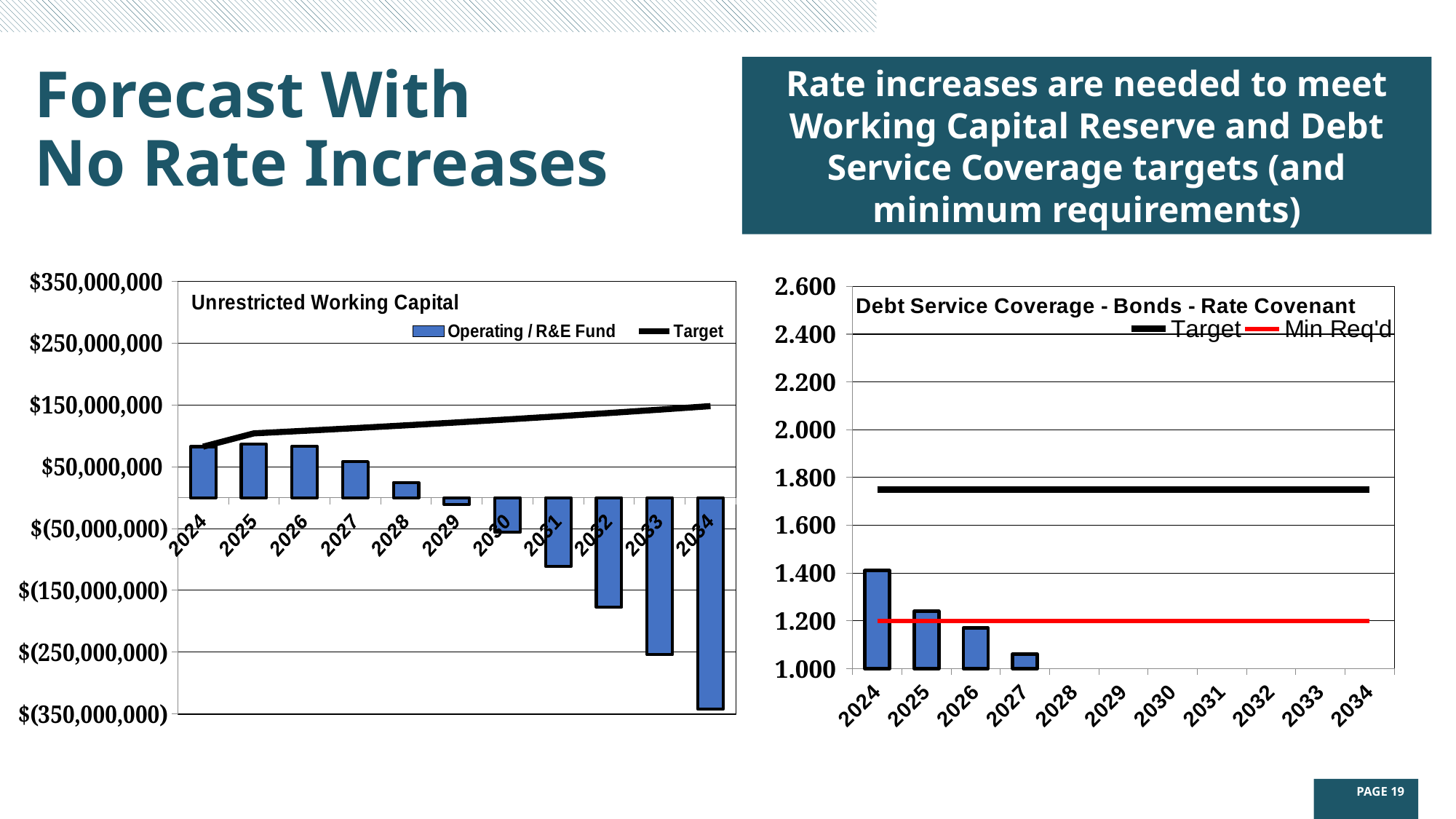
In the Unrestricted Working Capital chart, is the Operating / R&E Fund value for 2024 greater or less than $50,000,000? greater What kind of chart is the Unrestricted Working Capital chart on the left? combination bar and line chart In the Unrestricted Working Capital chart, is the Operating / R&E Fund value for 2034 greater or less than $(250,000,000)? less How many years are shown on the x axis of the Unrestricted Working Capital chart? 11 In the Debt Service Coverage - Bonds - Rate Covenant chart, which year has the highest bar? 2024 In the Unrestricted Working Capital chart, do the Operating / R&E Fund values generally rise or fall from 2024 to 2034? fall Which two line series does the legend of the Debt Service Coverage - Bonds - Rate Covenant chart list? Target and Min Req'd In the Unrestricted Working Capital chart, which year has the lowest Operating / R&E Fund value? 2034 In the Debt Service Coverage - Bonds - Rate Covenant chart, is the value for 2027 greater or less than 1.200? less In the Unrestricted Working Capital chart, which is larger, the Operating / R&E Fund value for 2027 or for 2032? 2027